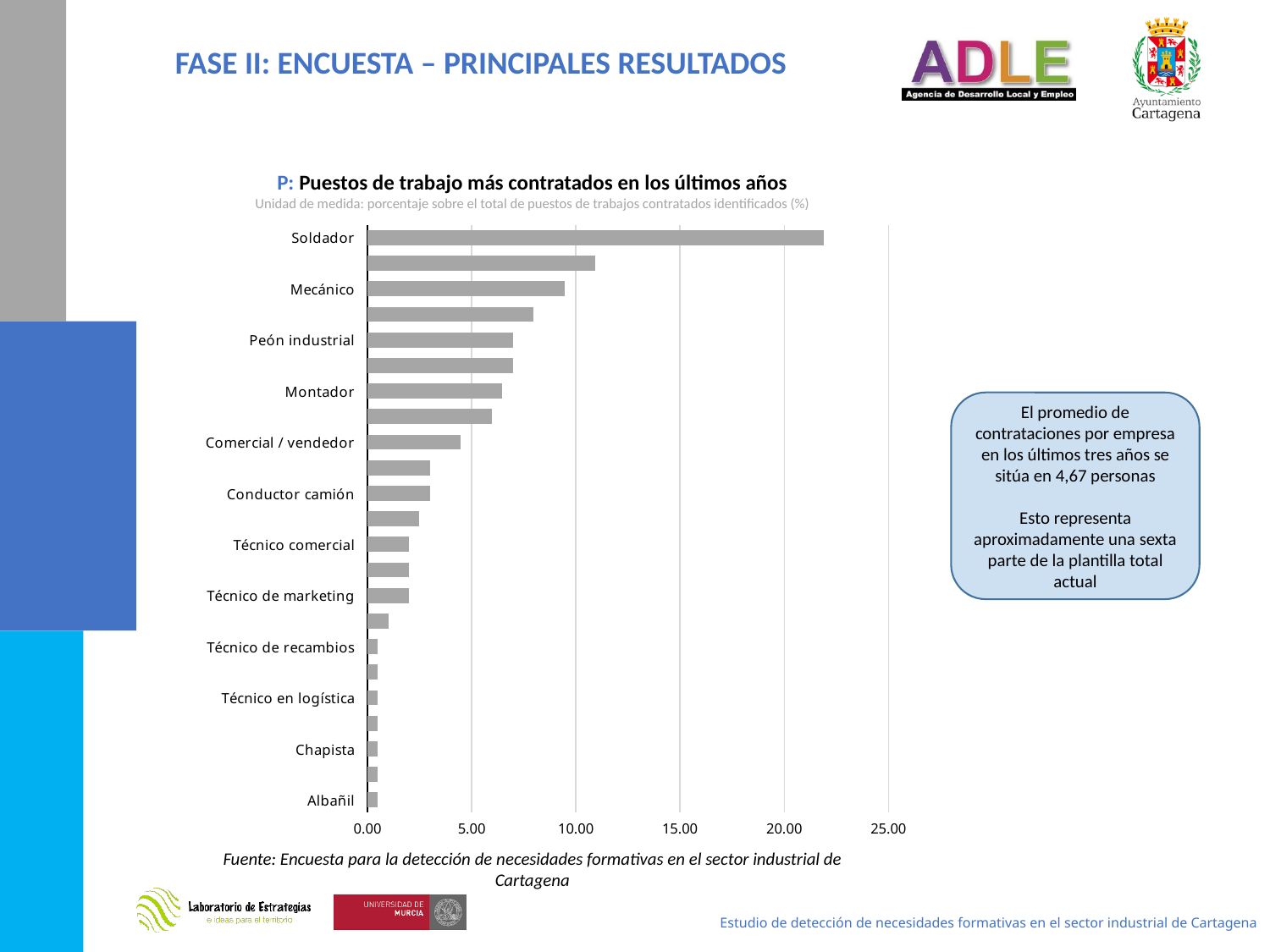
What is the highest value shown on the horizontal axis of the chart? 25.00 How many job positions are labelled on the vertical axis of the chart? 12 Which has a larger value, Mecánico or Montador? Mecánico Which labelled job position has the highest percentage in the chart? Soldador Is the value for Técnico comercial greater or less than 5.00? less Is the value for Peón industrial greater or less than 5.00? greater What kind of chart is shown on the slide? bar chart Is the value for Comercial / vendedor greater or less than 5.00? less Do the bar values increase or decrease going from the top of the chart (Soldador) to the bottom (Albañil)? decrease Which has a larger value, Soldador or Mecánico? Soldador